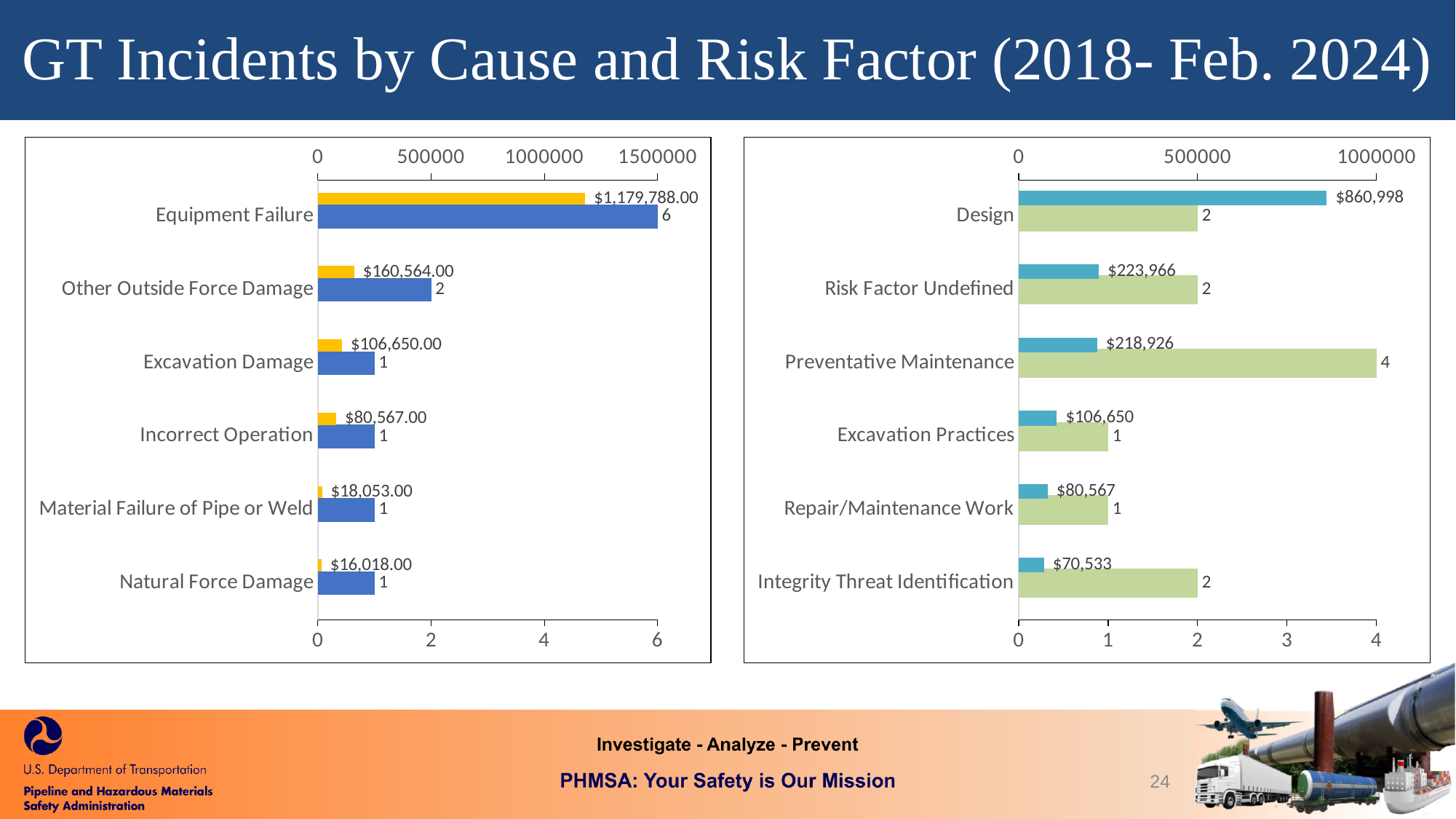
In the left chart, how many causes are listed? 6 In the left chart, which cause has the highest dollar value? Equipment Failure In the left chart, what is the dollar value shown for Equipment Failure? $1,179,788.00 In the right chart, what is the dollar value shown for Preventative Maintenance? $218,926 In the right chart, which risk factor has the lowest dollar value? Integrity Threat Identification In the right chart, which has a larger dollar value, Risk Factor Undefined or Preventative Maintenance? Risk Factor Undefined In the left chart, what is the incident count shown for Other Outside Force Damage? 2 In the left chart, what is the difference between the dollar values for Other Outside Force Damage and Excavation Damage? $53,914.00 In the left chart, which cause has the lowest dollar value? Natural Force Damage In the right chart, which risk factor has the highest incident count? Preventative Maintenance What type of chart is the right chart? Bar chart In the right chart, what is the difference between the dollar values for Design and Risk Factor Undefined? $637,032